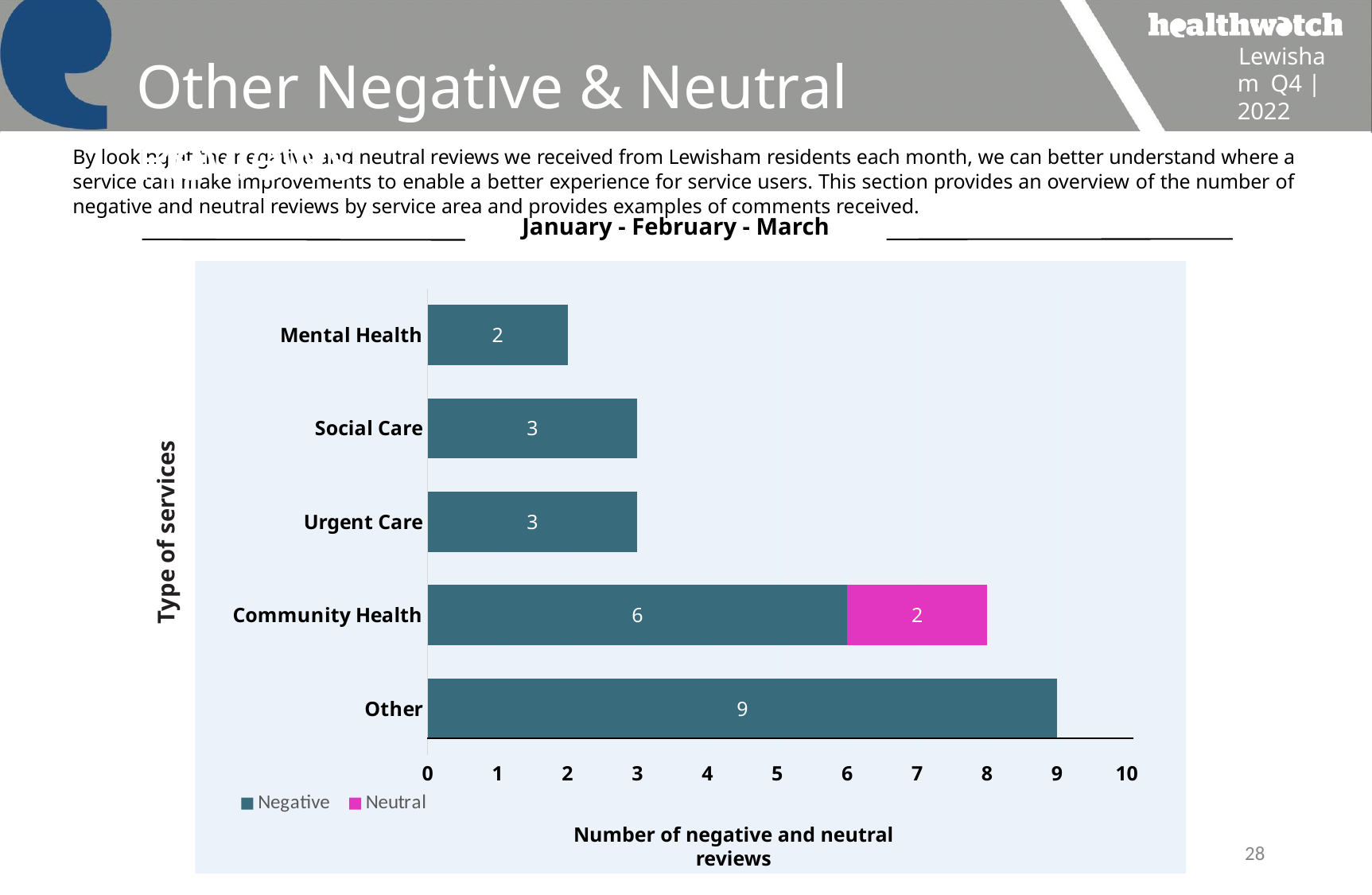
Which has more Negative reviews, Social Care or Mental Health? Social Care How many types of services are shown on the chart? 5 What is the total number of negative and neutral reviews for Community Health? 8 What is the number of Neutral reviews for Community Health? 2 Which type of service has the lowest number of Negative reviews? Mental Health Which type of service has the highest number of Negative reviews? Other What is the number of Negative reviews for Mental Health? 2 What is the difference between the Negative reviews for Other and for Community Health? 3 What kind of chart is shown on the slide? Bar chart What is the number of Negative reviews for Community Health? 6 What is the number of Negative reviews for Other? 9 How many series does the legend list? 2